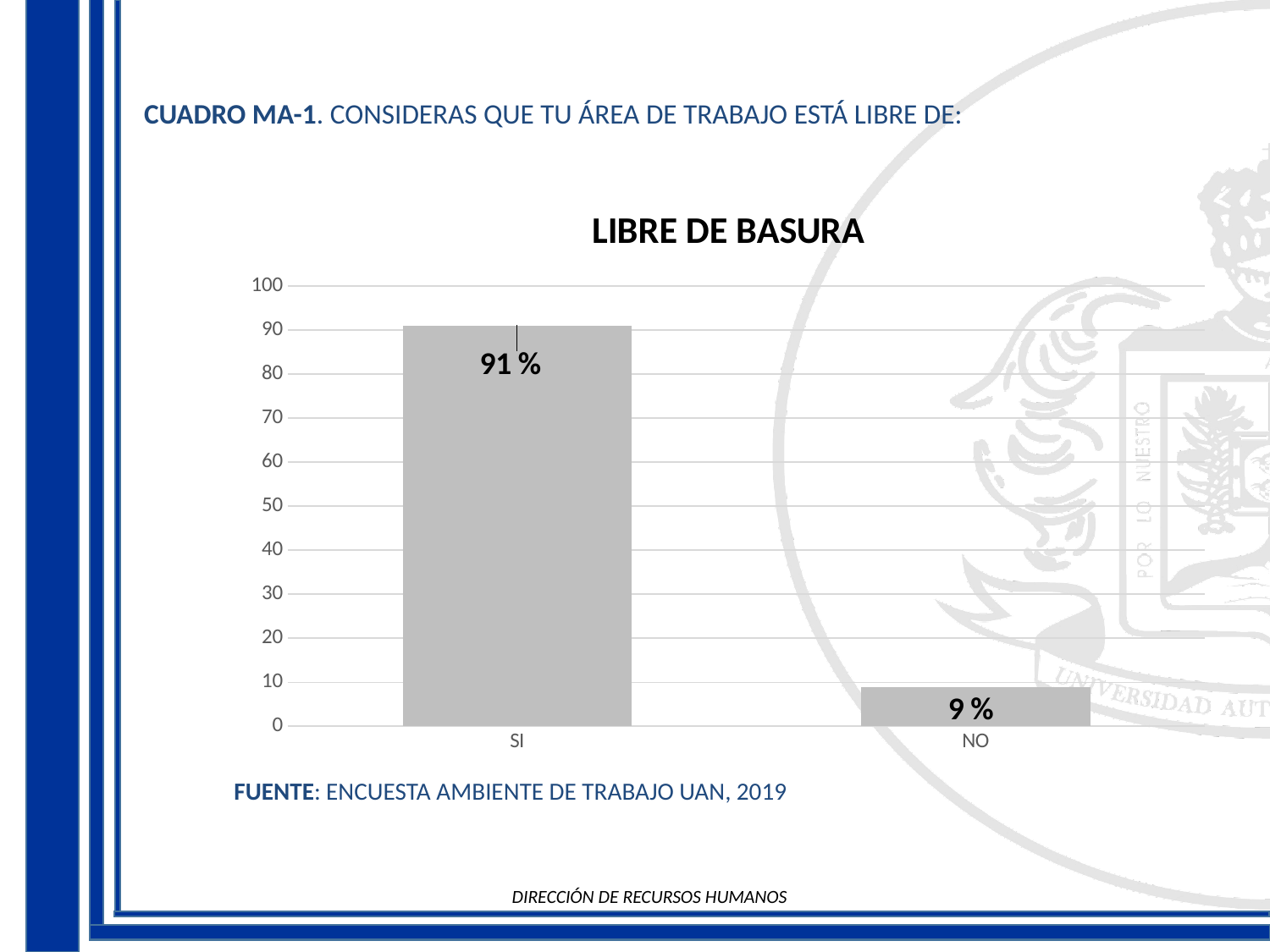
What is the title of the chart? LIBRE DE BASURA What is the highest value shown on the y axis? 100 Which category has the lowest value? NO Which category has the highest value? SI What is the value for NO? 9 % Is the value for NO greater or less than 10? less How many categories are shown on the x axis? 2 What is the value for SI? 91 % Is the value for SI greater or less than 50? greater What kind of chart is shown? bar chart What is the difference between the values for SI and NO? 82 % Which is larger, the value for SI or the value for NO? SI